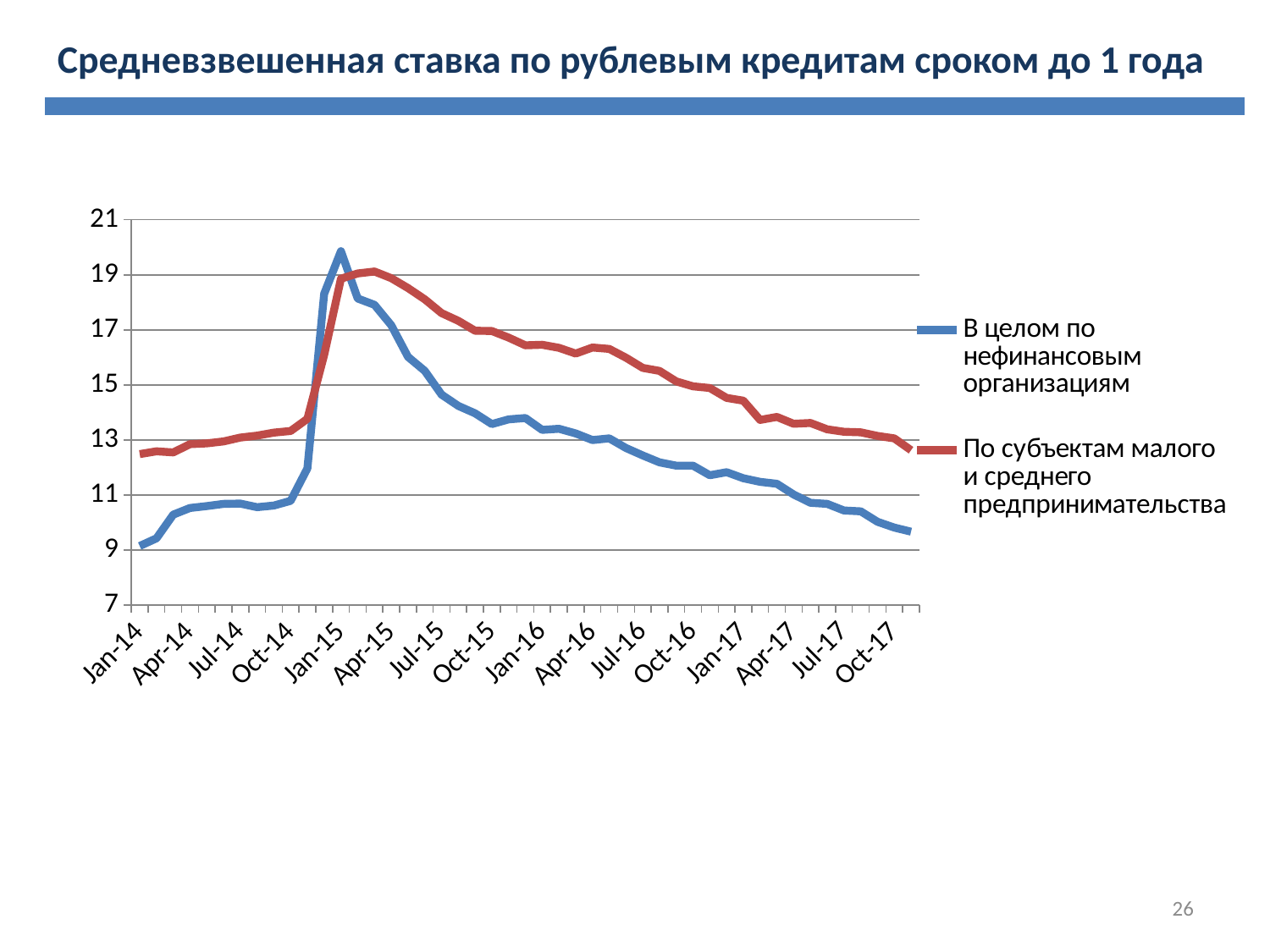
Is the value for 'По субъектам малого и среднего предпринимательства' at Jan-14 greater or less than 13? less Do the values of 'В целом по нефинансовым организациям' rise or fall from Apr-15 to Oct-17? fall Is the value for 'По субъектам малого и среднего предпринимательства' at Jan-16 greater or less than 15? greater What kind of chart is shown on the slide? line chart Is the peak value of 'В целом по нефинансовым организациям' in early 2015 greater or less than 19? greater Which series has the higher value at Oct-17? По субъектам малого и среднего предпринимательства Which series reaches the higher peak value in early 2015? В целом по нефинансовым организациям What is the title of the chart on the slide? Средневзвешенная ставка по рублевым кредитам сроком до 1 года How many series does the legend list? 2 Which series is drawn in red? По субъектам малого и среднего предпринимательства